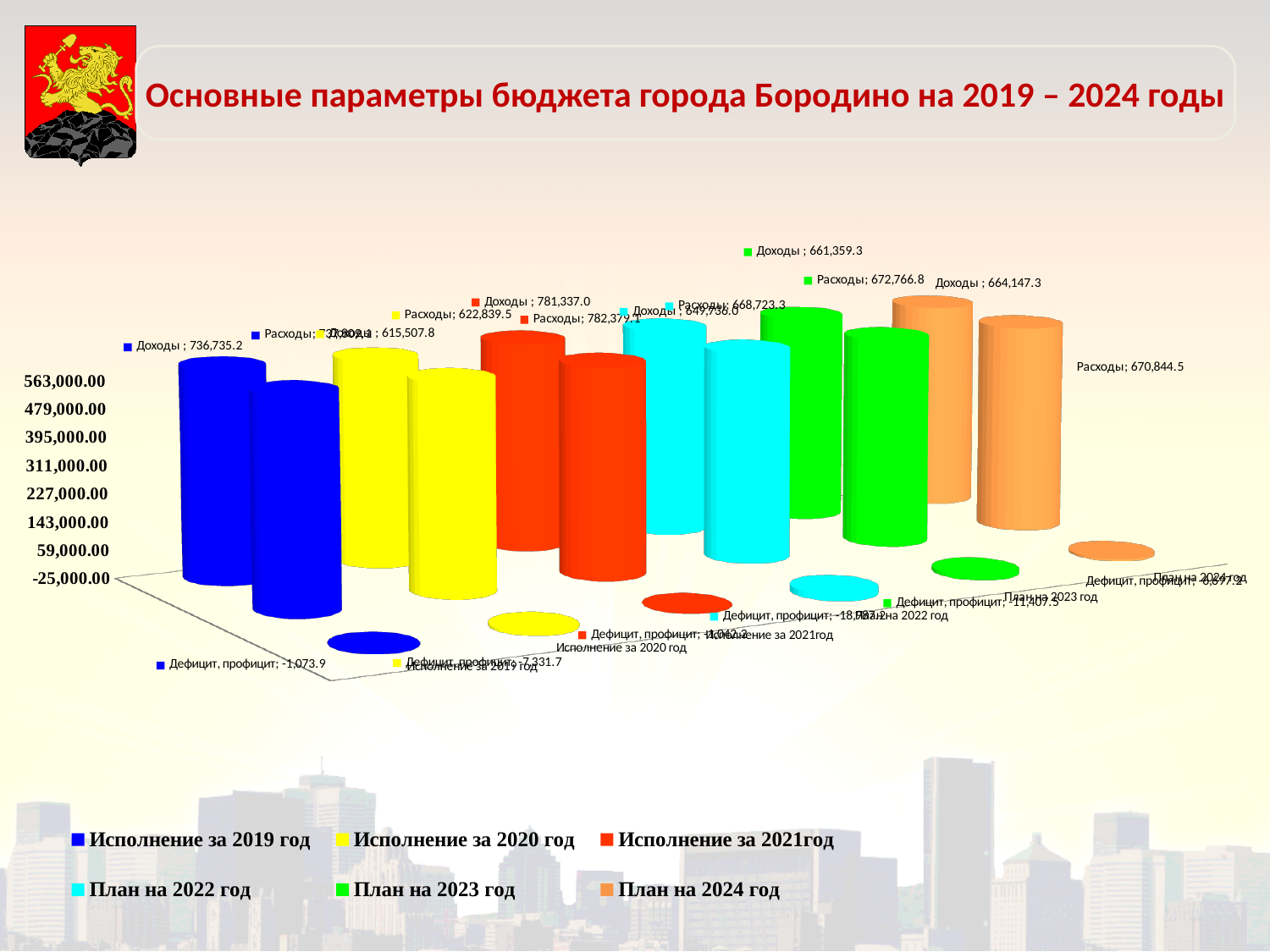
Which series has the highest value for Доходы? Исполнение за 2021год What is the value of Доходы for Исполнение за 2021год? 781,337.0 How many series does the legend list? 6 What is the value of Дефицит, профицит for Исполнение за 2019 год? -1,073.9 Which is larger: Доходы for План на 2023 год or Доходы for План на 2024 год? План на 2024 год Which series has the lowest value for Доходы? Исполнение за 2020 год What is the value of Доходы for Исполнение за 2019 год? 736,735.2 What is the value of Расходы for План на 2024 год? 670,844.5 What type of chart is shown on the slide? Bar chart What is the value of Расходы for План на 2022 год? 668,723.3 What is the value of Расходы for Исполнение за 2020 год? 622,839.5 What is the difference between Расходы and Доходы for Исполнение за 2021год? 1,042.1